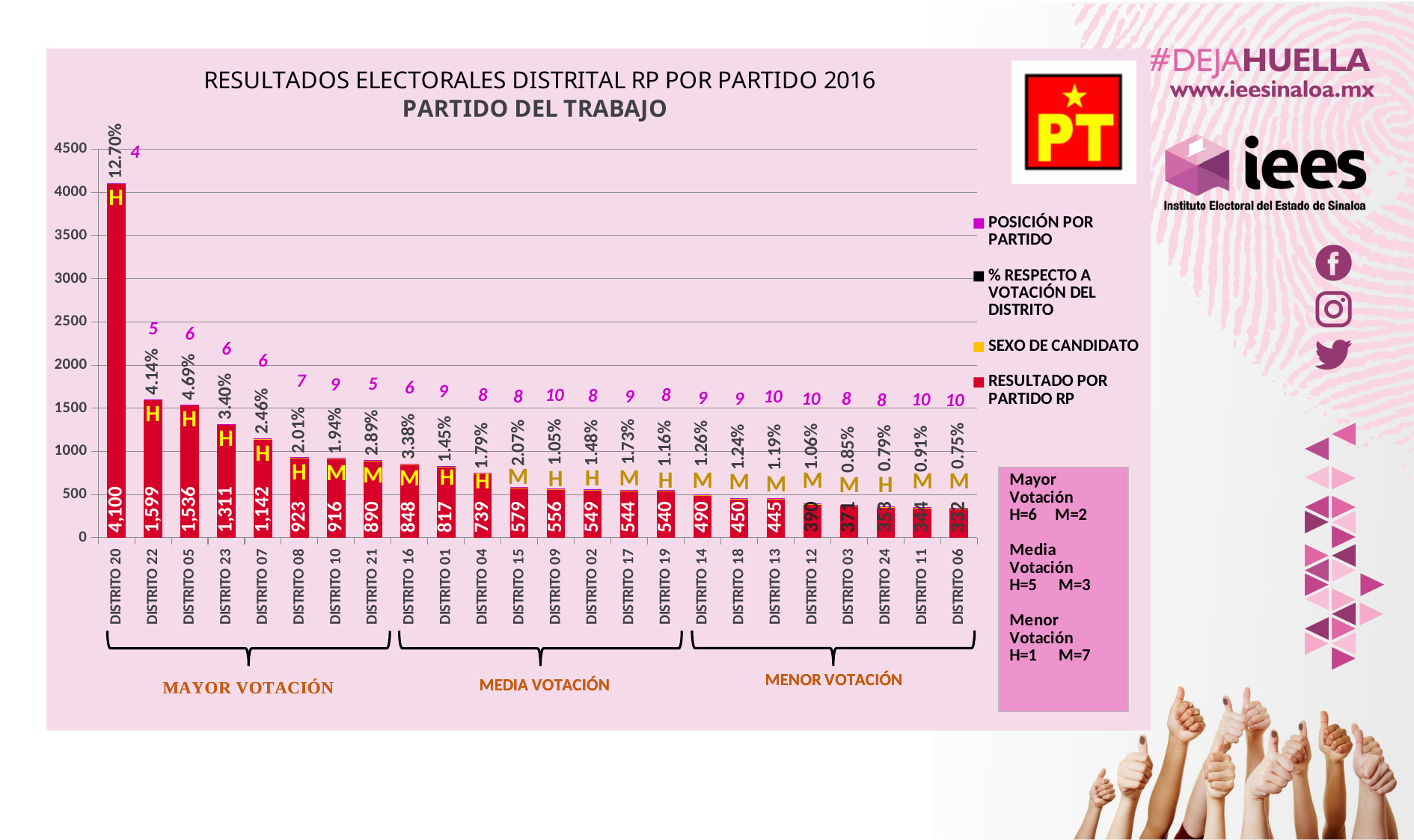
How many series does the chart legend list? 4 Which district has the lowest RESULTADO POR PARTIDO RP? DISTRITO 06 What is the RESULTADO POR PARTIDO RP value for DISTRITO 16? 848 Which has a larger RESULTADO POR PARTIDO RP, DISTRITO 08 or DISTRITO 15? DISTRITO 08 Which district has the highest RESULTADO POR PARTIDO RP? DISTRITO 20 Is the RESULTADO POR PARTIDO RP value for DISTRITO 23 greater or less than 1000? greater What percentage (% RESPECTO A VOTACIÓN DEL DISTRITO) is shown for DISTRITO 05? 4.69% Do the RESULTADO POR PARTIDO RP values rise or fall from left to right along the x axis? fall How many districts are shown on the x axis of the chart? 24 What kind of chart is shown on the slide? bar chart What is the difference between the RESULTADO POR PARTIDO RP values of DISTRITO 22 and DISTRITO 05? 63 What is the RESULTADO POR PARTIDO RP value for DISTRITO 20? 4,100